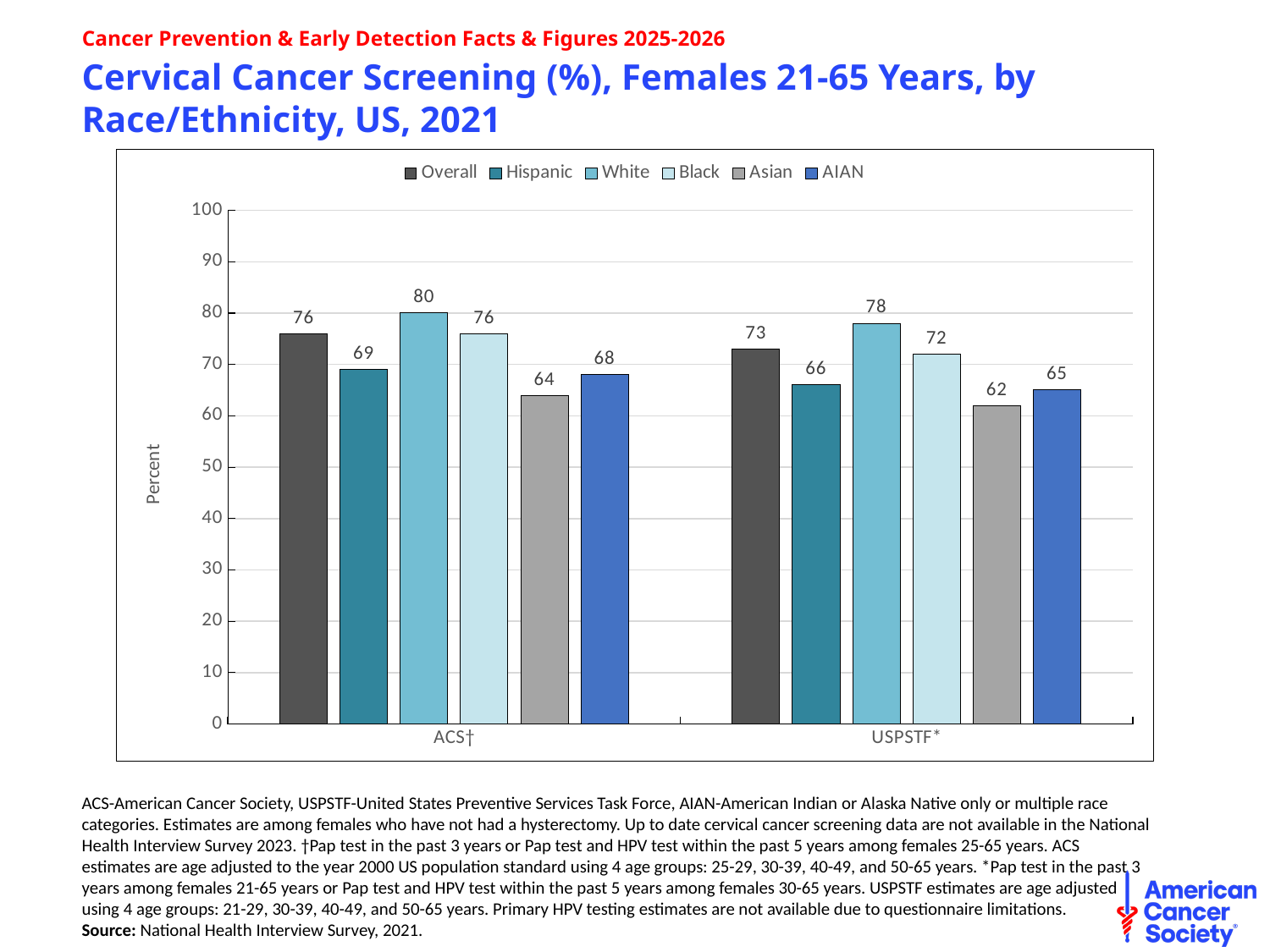
What is the difference between the White and Asian values under the ACS† guideline? 16 What is the cervical cancer screening percentage for White females under the ACS† guideline? 80 What is the Overall value for the USPSTF* group? 73 What is the difference between the Black values for ACS† and USPSTF*? 4 What kind of chart is shown on the slide? bar chart How many categories are shown on the x axis? 2 What is the value for Asian females under the USPSTF* guideline? 62 Which race/ethnicity group has the lowest screening percentage under the USPSTF* guideline? Asian Which race/ethnicity group has the highest screening percentage under the ACS† guideline? White What is the label of the y axis? Percent Is the Hispanic value under the ACS† guideline larger or smaller than the Hispanic value under the USPSTF* guideline? larger How many series does the legend list? 6